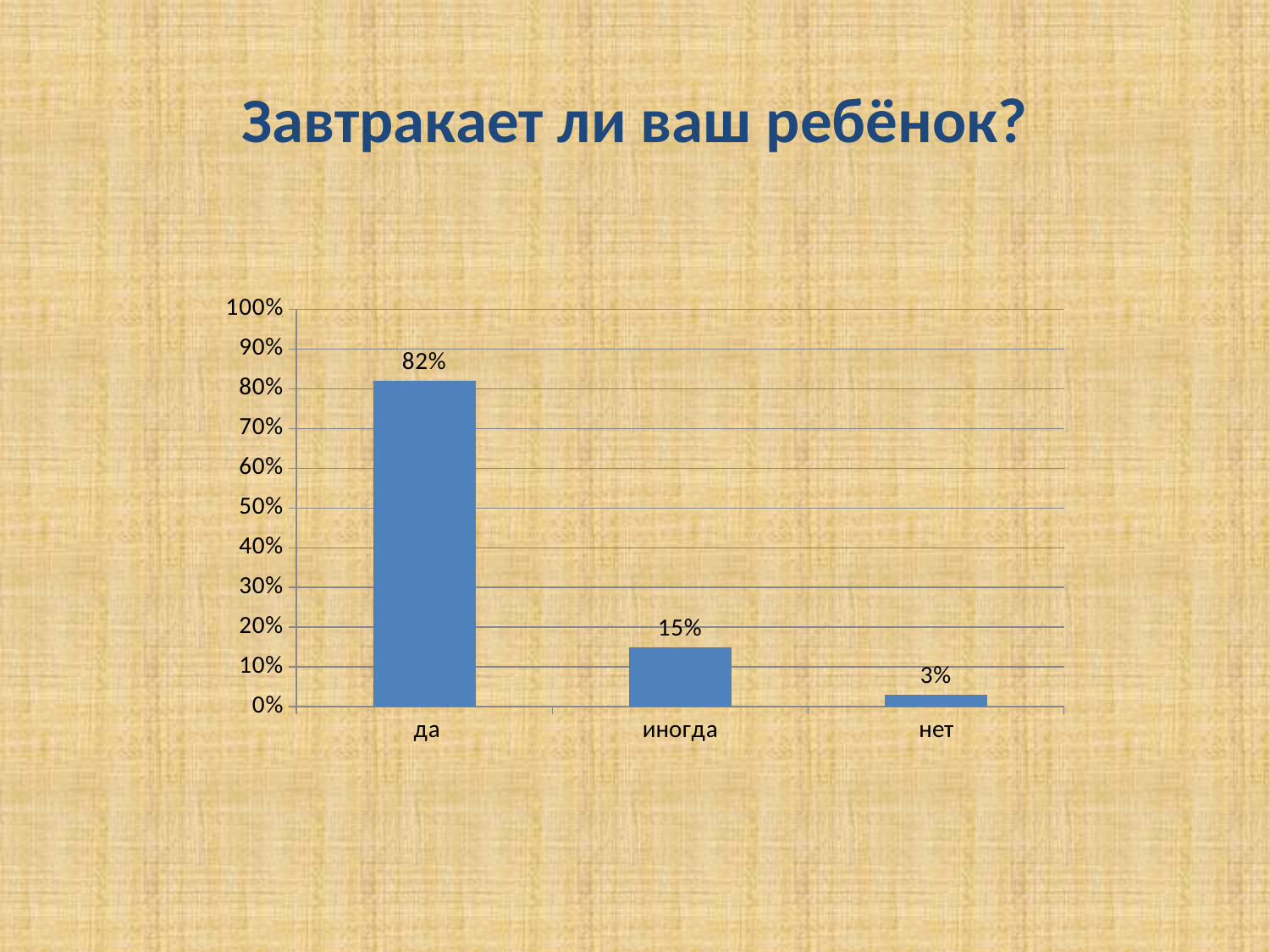
What is the difference between the values for "да" and "иногда"? 67% How many categories are shown on the x axis? 3 What kind of chart is shown on the slide? bar chart What is the title of the slide? Завтракает ли ваш ребёнок? Which is larger, the value for "иногда" or the value for "нет"? иногда What is the difference between the values for "иногда" and "нет"? 12% Which category has the lowest value? нет Which category has the highest value? да What is the value for "иногда"? 15% What is the value for "нет"? 3% Is the value for "да" greater or less than 50%? greater What is the value for "да"? 82%